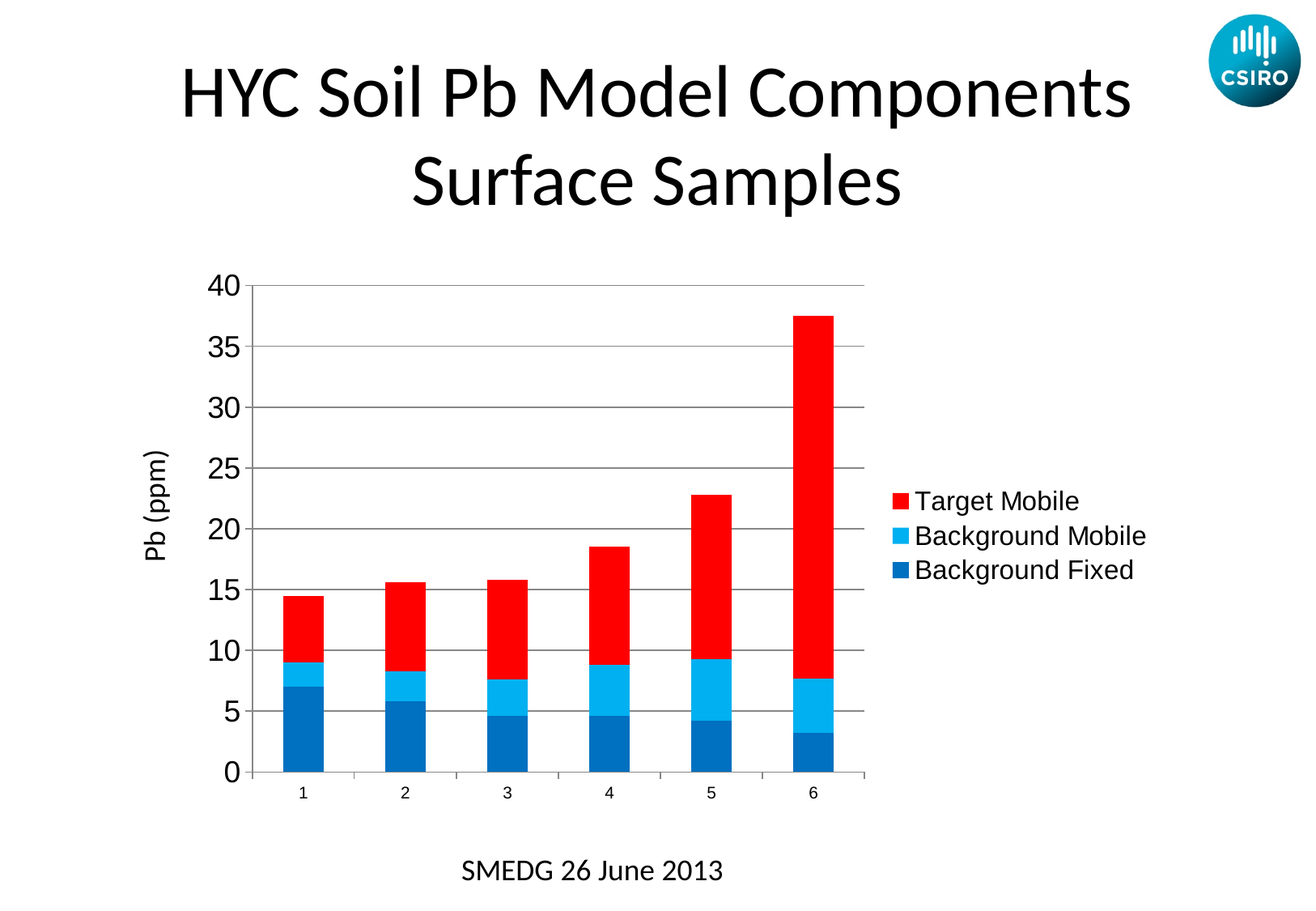
Which sample has the highest total Pb (ppm)? 6 Which sample has the largest Background Fixed component? 1 Which sample has the smallest Background Fixed component? 6 How many series does the legend list? 3 Do the total bar heights generally rise or fall from sample 1 to sample 6? Rise Is the total Pb (ppm) for sample 1 greater or less than 15? less Is the total Pb (ppm) for sample 6 greater or less than 35? greater Which has a larger total Pb (ppm), sample 5 or sample 6? Sample 6 Is the total Pb (ppm) for sample 5 greater or less than 20? greater What is the label on the y axis? Pb (ppm) How many samples (categories) are shown on the x axis? 6 What kind of chart is shown on the slide? Stacked bar chart